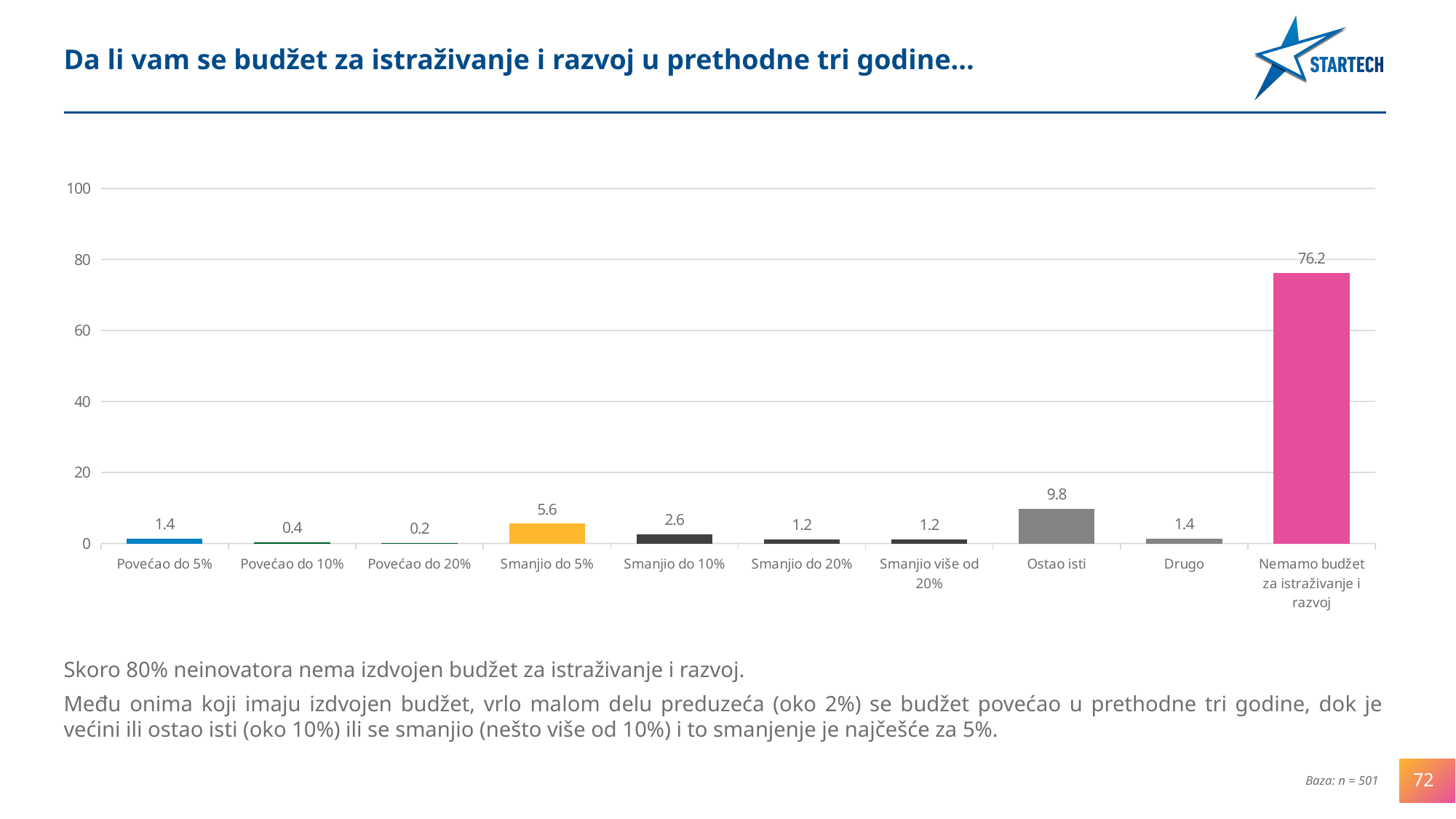
Which is larger, the value for "Smanjio do 10%" or the value for "Povećao do 5%"? Smanjio do 10% What is the value for "Nemamo budžet za istraživanje i razvoj"? 76.2 Which category has the highest value? Nemamo budžet za istraživanje i razvoj What kind of chart is shown on the slide? bar chart Which category has the lowest value? Povećao do 20% What is the value for "Smanjio do 5%"? 5.6 What is the title of the slide? Da li vam se budžet za istraživanje i razvoj u prethodne tri godine… How many categories are shown on the x axis? 10 What is the difference between the values for "Ostao isti" and "Smanjio do 5%"? 4.2 Is the value for "Nemamo budžet za istraživanje i razvoj" greater or less than 60? greater What is the value for "Ostao isti"? 9.8 What is the value for "Povećao do 10%"? 0.4